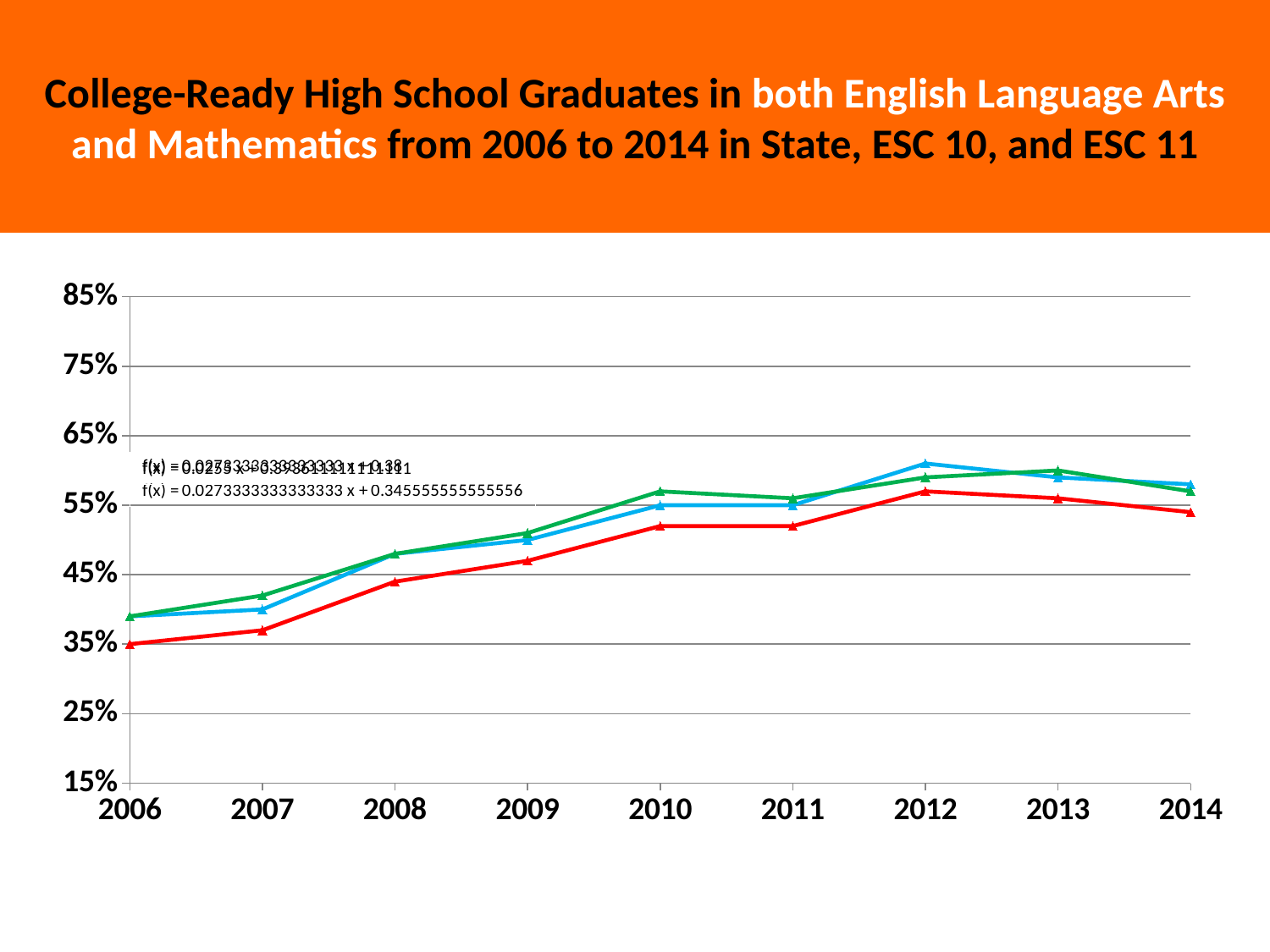
How many years are shown along the x axis of the chart? 9 In 2008, which line has the higher value, the red line or the blue line? blue line What kind of chart is shown on the slide? line chart What is the highest value shown on the y axis of the chart? 85% Is the value of the green line in 2010 greater or less than 55%? greater Is the value of the blue line in 2012 greater or less than 55%? greater Does the red line rise or fall from 2006 to 2012? rise In which year does the red line reach its highest value? 2012 Does the blue line rise or fall from 2012 to 2014? fall How many lines are plotted on the chart? 3 Is the value of the red line in 2011 greater or less than 55%? less